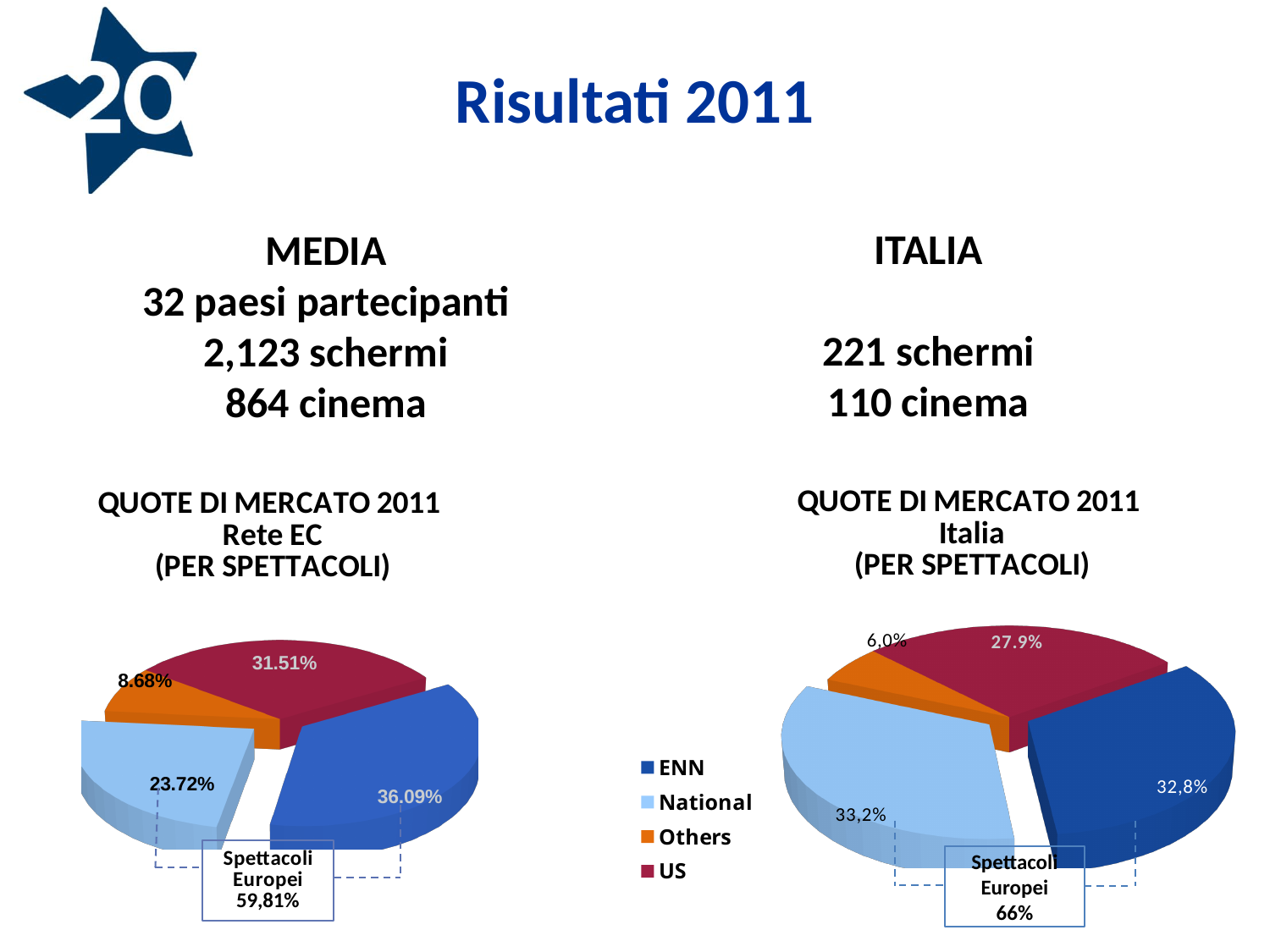
In the QUOTE DI MERCATO 2011 Italia chart, what is the share for US? 27.9% In the QUOTE DI MERCATO 2011 Rete EC chart, which category has the largest slice? ENN How many entries does the legend shared by the two charts list? 4 In the QUOTE DI MERCATO 2011 Rete EC chart, what is the share for US? 31.51% What kind of chart is the QUOTE DI MERCATO 2011 Italia chart? Pie chart In the QUOTE DI MERCATO 2011 Rete EC chart, what combined share is given for Spettacoli Europei? 59,81% In the QUOTE DI MERCATO 2011 Italia chart, what is the share for ENN? 32,8% In the QUOTE DI MERCATO 2011 Rete EC chart, which category has the smallest slice? Others In the QUOTE DI MERCATO 2011 Italia chart, which is larger, National or US? National In the QUOTE DI MERCATO 2011 Italia chart, what is the share for Others? 6,0% In the QUOTE DI MERCATO 2011 Rete EC chart, what is the share for Others? 8.68% In the QUOTE DI MERCATO 2011 Rete EC chart, what is the difference between the ENN share and the US share? 4.58%